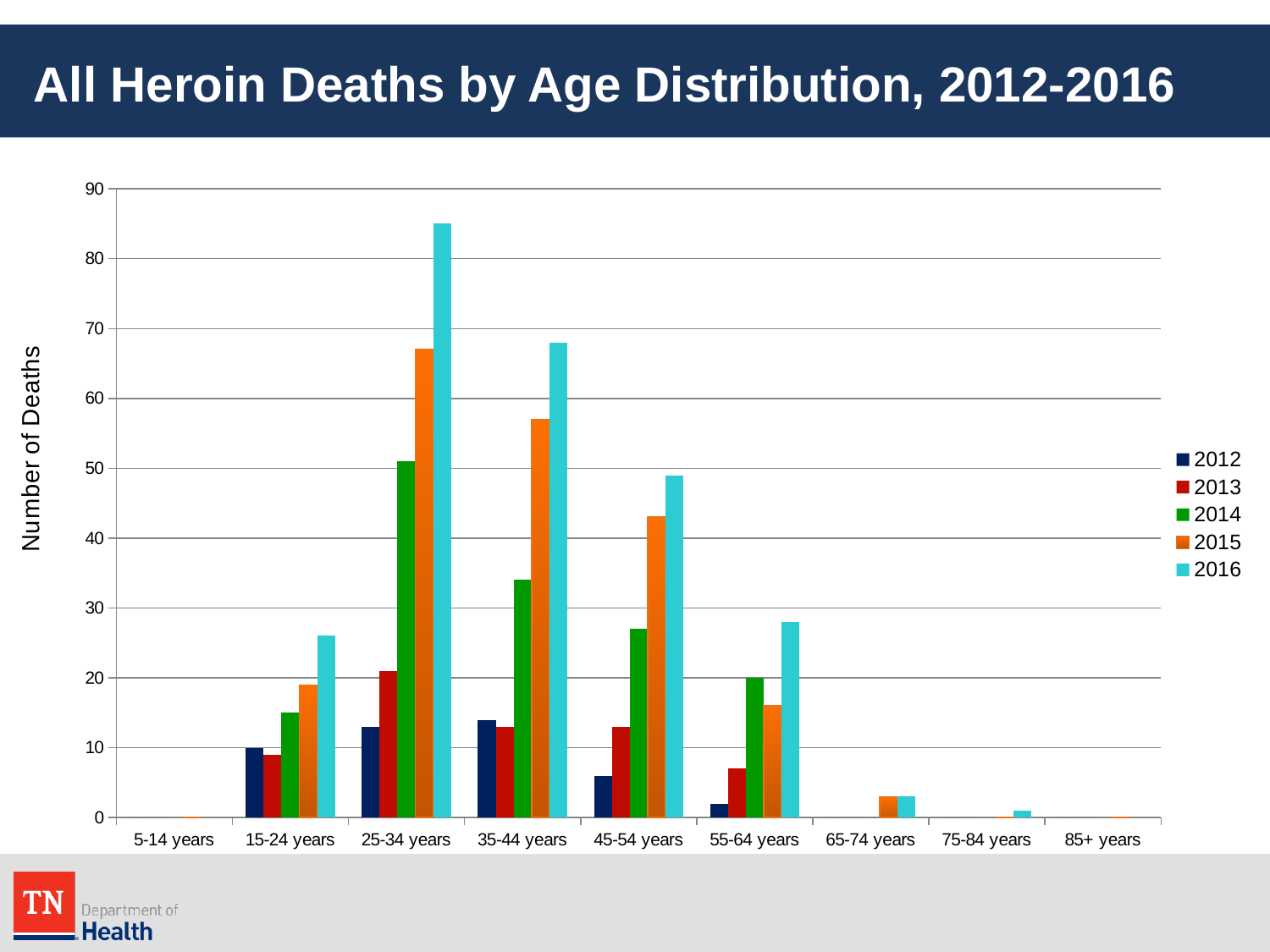
Within the 25-34 years age group, which year has the highest number of deaths? 2016 How many series does the legend list? 5 Is the value for 2016 in the 55-64 years group greater or less than 30? less Is the value for 2014 in the 35-44 years group greater or less than 30? greater Which age group has the highest number of deaths for 2016? 25-34 years Is the value for 2016 in the 25-34 years group greater or less than 80? greater Within the 25-34 years age group, do the values rise or fall from 2012 to 2016? rise How many age groups are shown on the x axis? 9 In the 35-44 years group, which is larger: the value for 2014 or the value for 2015? 2015 What is the label on the y axis? Number of Deaths What kind of chart is shown on the slide? bar chart